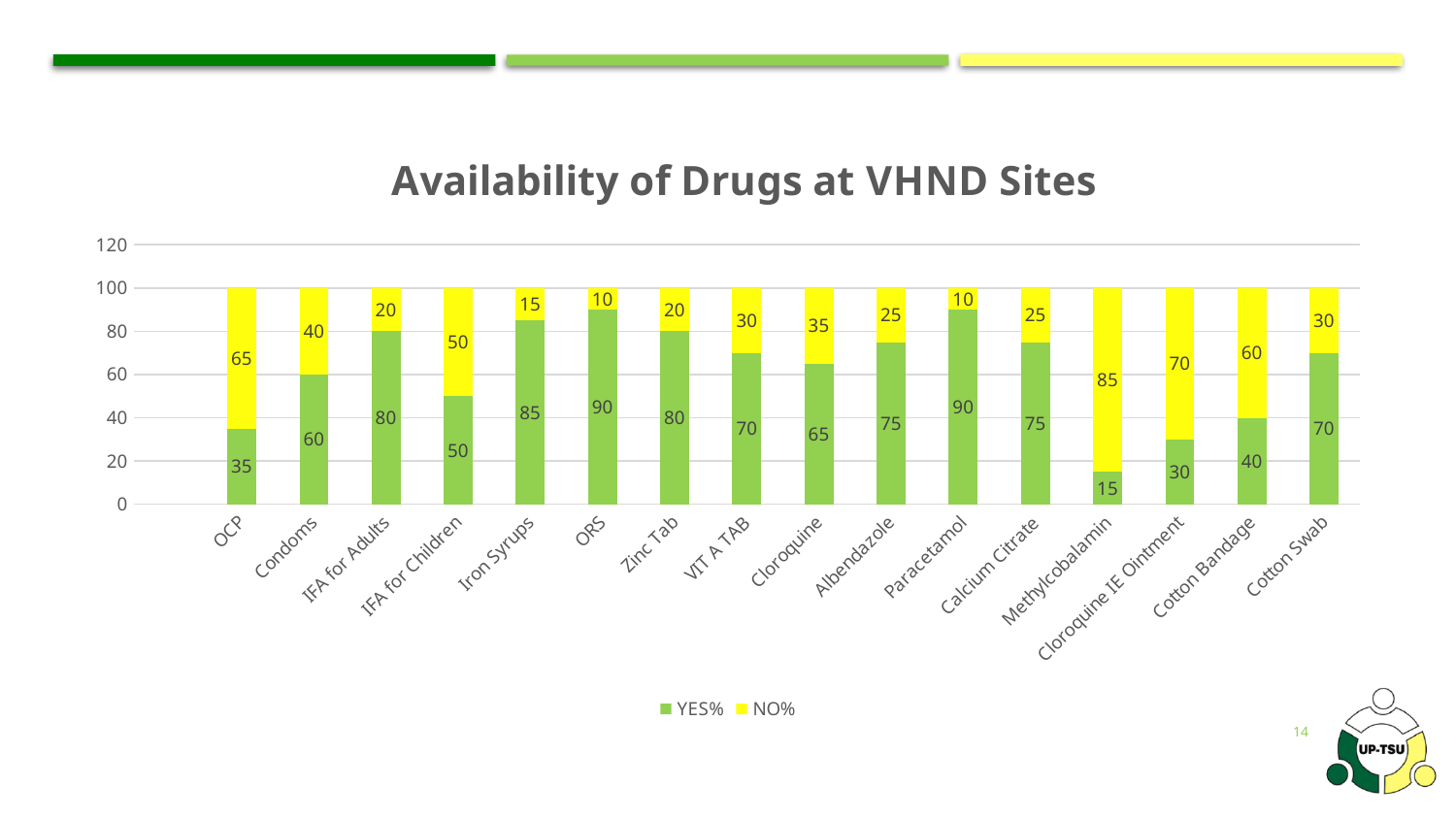
Which category has the lowest YES% value? Methylcobalamin What is the total of the stacked bar for Zinc Tab? 100 What is the YES% value for OCP? 35 Which has a larger YES% value, Albendazole or Cloroquine IE Ointment? Albendazole What is the YES% value for Iron Syrups? 85 How many series does the legend list? 2 What is the NO% value for Cotton Bandage? 60 How many drug categories are shown on the x axis? 16 Which category has the highest NO% value? Methylcobalamin What is the NO% value for Methylcobalamin? 85 What is the difference between the YES% values for ORS and Condoms? 30 What kind of chart is shown on the slide? Stacked bar chart